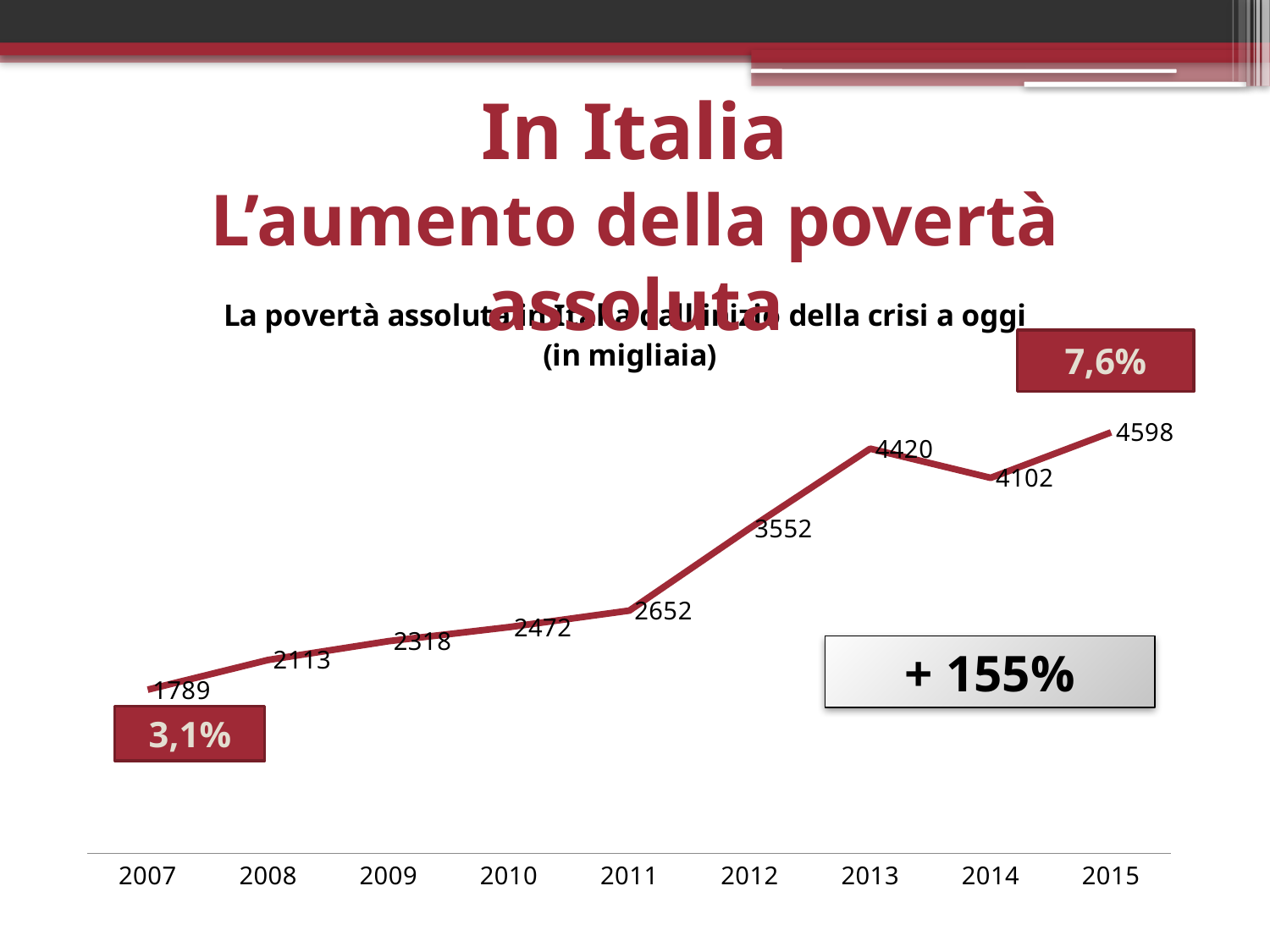
What is the value for 2014? 4102 Which year has the lowest value? 2007 What is the value for 2012? 3552 Do the values generally rise or fall from 2007 to 2015? rise Which year has the highest value? 2015 How many years are plotted on the x axis? 9 What kind of chart is shown? line chart Which is larger, the value for 2013 or the value for 2014? 2013 What percentage is shown in the box at the top right of the chart? 7,6% What is the value for 2007? 1789 What is the difference between the values for 2015 and 2007? 2809 What is the difference between the values for 2013 and 2014? 318